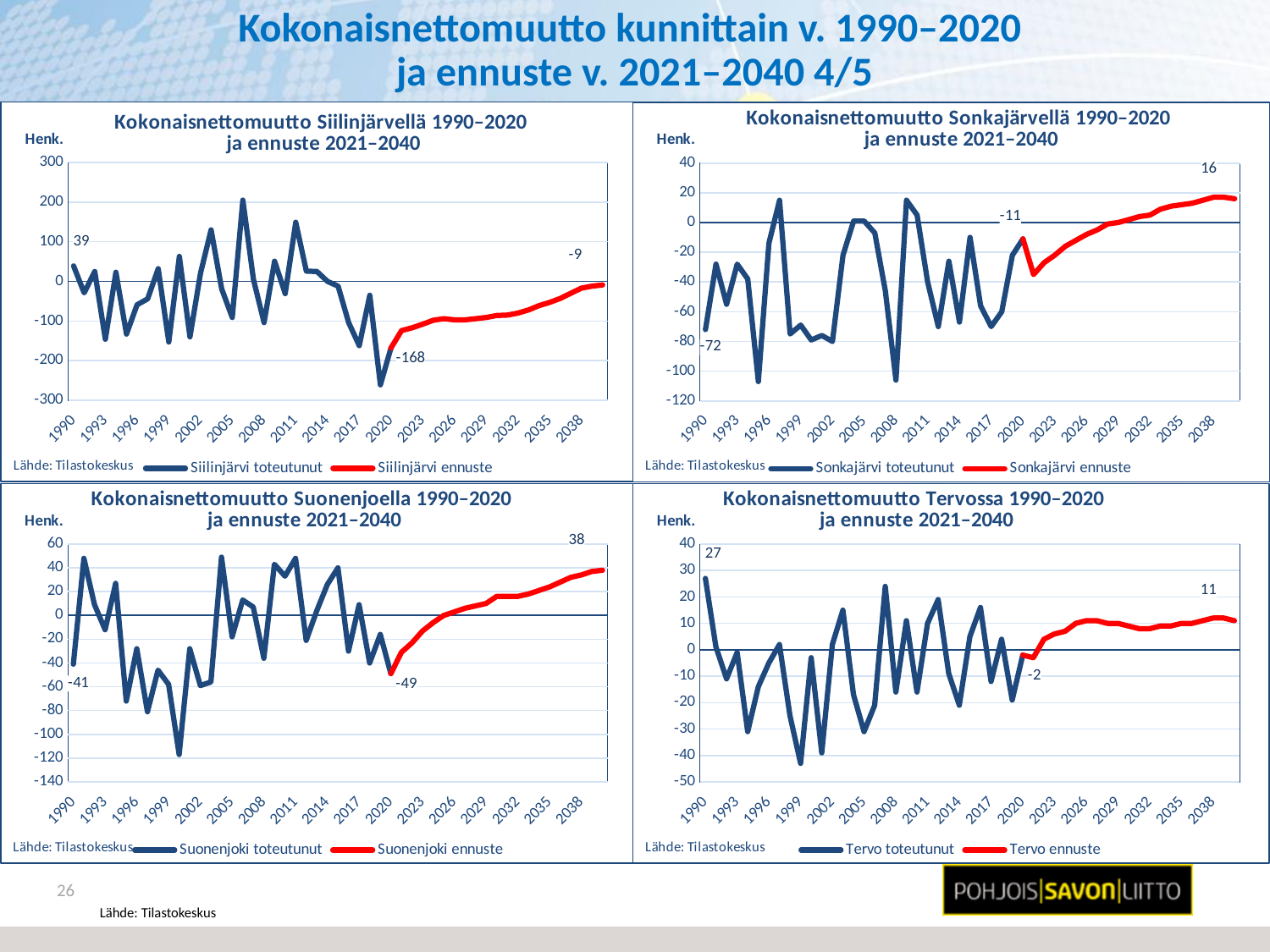
In the Suonenjoki chart (bottom left), what is the labelled value for 2020? -49 In the Tervo chart (bottom right), what is the labelled value for 1990? 27 In the Siilinjärvi chart (top left), what is the labelled forecast value at the end of the series (2040)? -9 What type of chart is used in the Sonkajärvi chart (top right)? Line chart In the Sonkajärvi chart (top right), what is the labelled value for 1990? -72 In the Suonenjoki chart (bottom left), what is the difference between the 2040 forecast value (38) and the 2020 value (-49)? 87 How many series does the legend of the Tervo chart (bottom right) list? 2 In the Siilinjärvi chart (top left), what is the labelled value for 1990? 39 In the Sonkajärvi chart (top right), what is the labelled forecast value at the end of the series (2040)? 16 In the Tervo chart (bottom right), which is larger: the 1990 value or the 2040 forecast value? 1990 value (27) In the Suonenjoki chart (bottom left), does the red forecast line rise or fall from 2021 to 2040? Rises In the Siilinjärvi chart (top left), what is the labelled value for 2020? -168